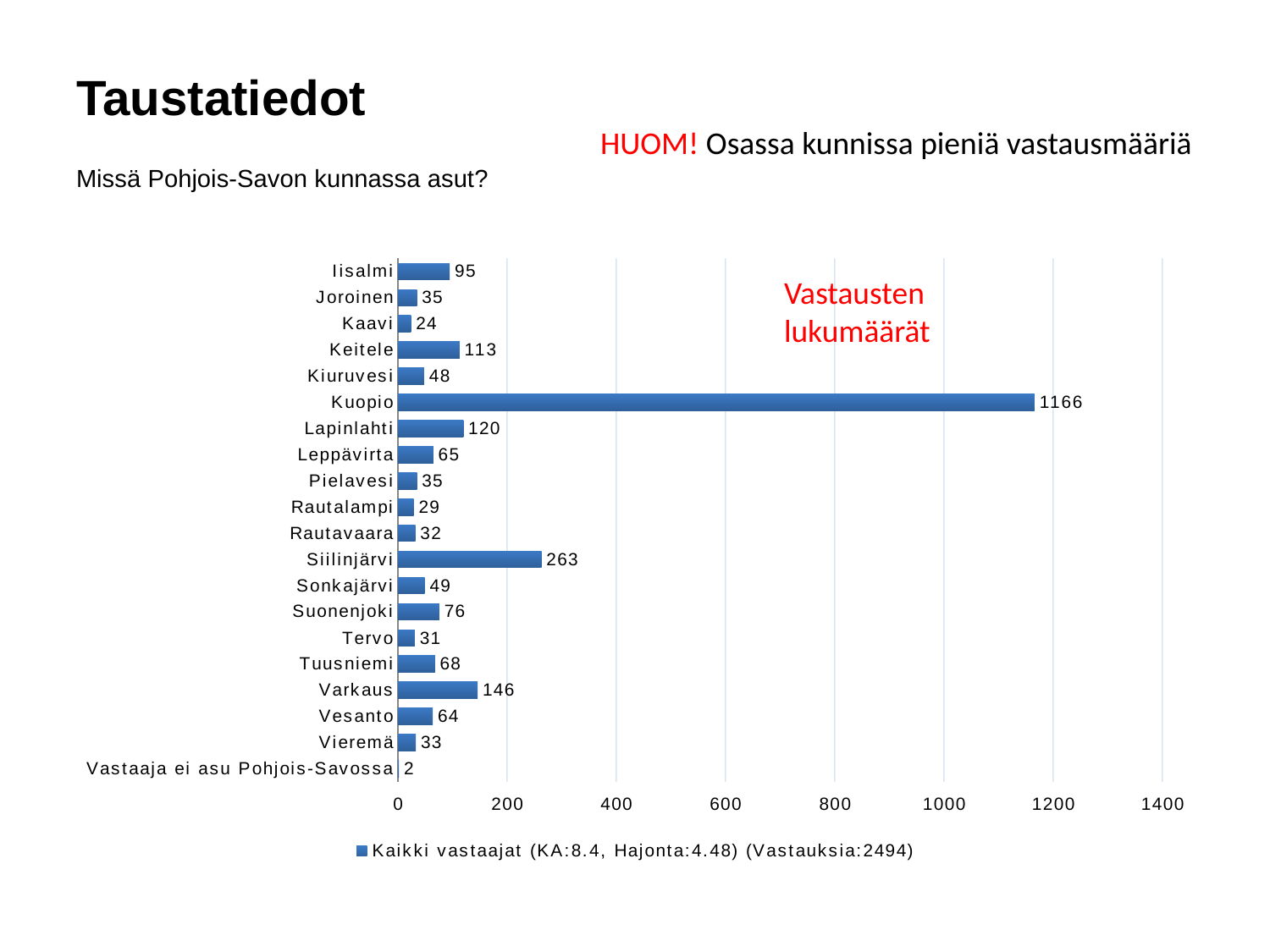
What is the value for Varkaus? 146 What is the value for Kuopio? 1166 Which category has the lowest value? Vastaaja ei asu Pohjois-Savossa What is the difference between the values for Kuopio and Siilinjärvi? 903 What is the legend entry for the series shown? Kaikki vastaajat (KA:8.4, Hajonta:4.48) (Vastauksia:2494) What is the value for Siilinjärvi? 263 Is the value for Siilinjärvi greater or less than 200? greater Which is larger, the value for Keitele or the value for Lapinlahti? Lapinlahti How many categories are shown on the chart? 20 Which category has the highest value? Kuopio How many series does the legend list? 1 What kind of chart is shown on the slide? bar chart